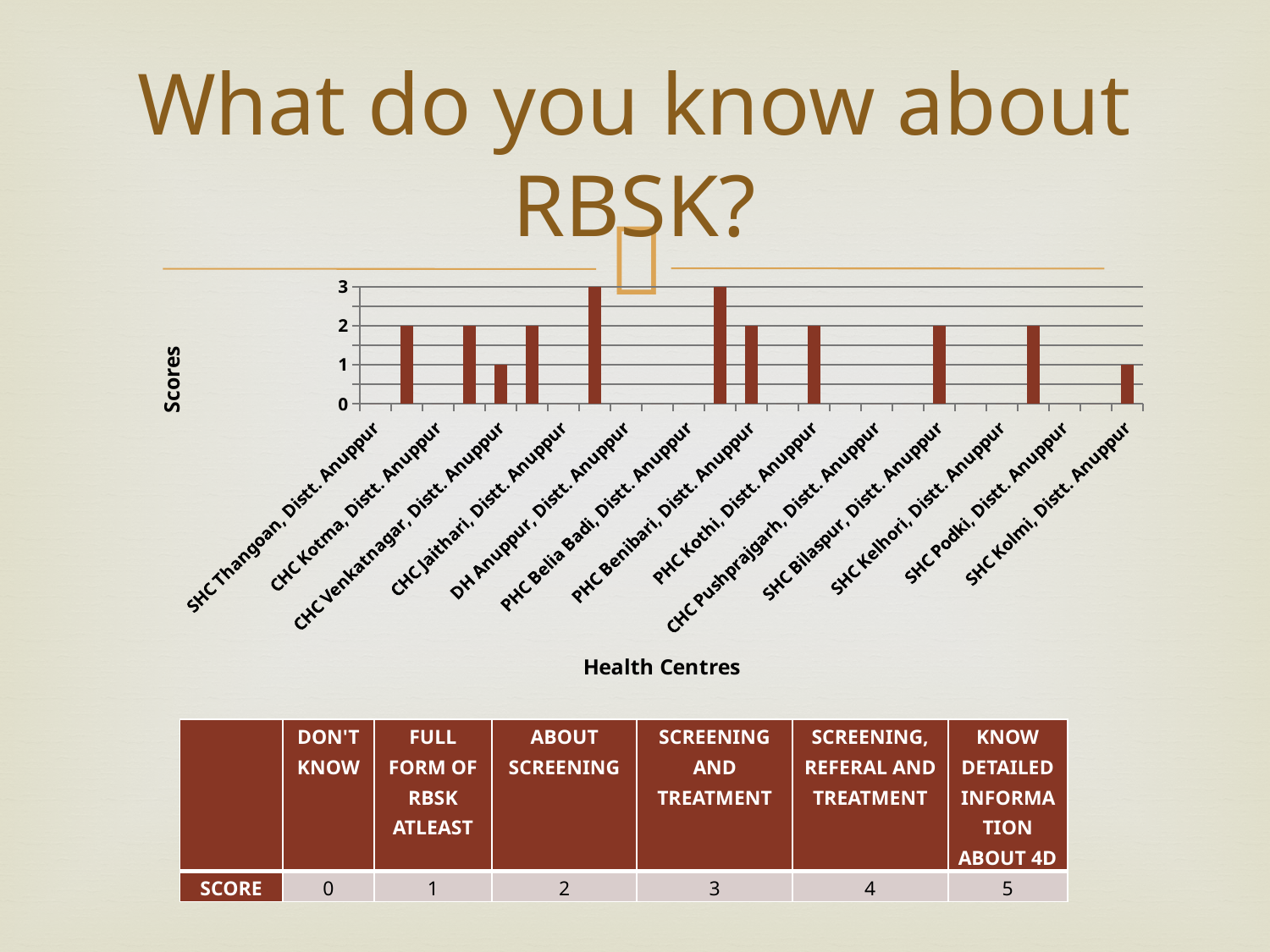
What is the lowest non-zero score shown by a bar in the chart? 1 How many bars in the chart have a score of 1? 2 What is the value of the leftmost bar in the chart? 2 What kind of chart is shown on the slide? bar chart What is the highest score reached by any bar in the chart? 3 How many bars in the chart reach a score of 3? 2 Is the leftmost bar's value greater or less than the rightmost bar's value? greater What is the maximum value shown on the y axis of the chart? 3 What is the title of the x axis of the chart? Health Centres What is the title of the y axis of the chart? Scores What is the value of the rightmost bar in the chart? 1 How many health centre labels are shown along the x axis of the chart? 13